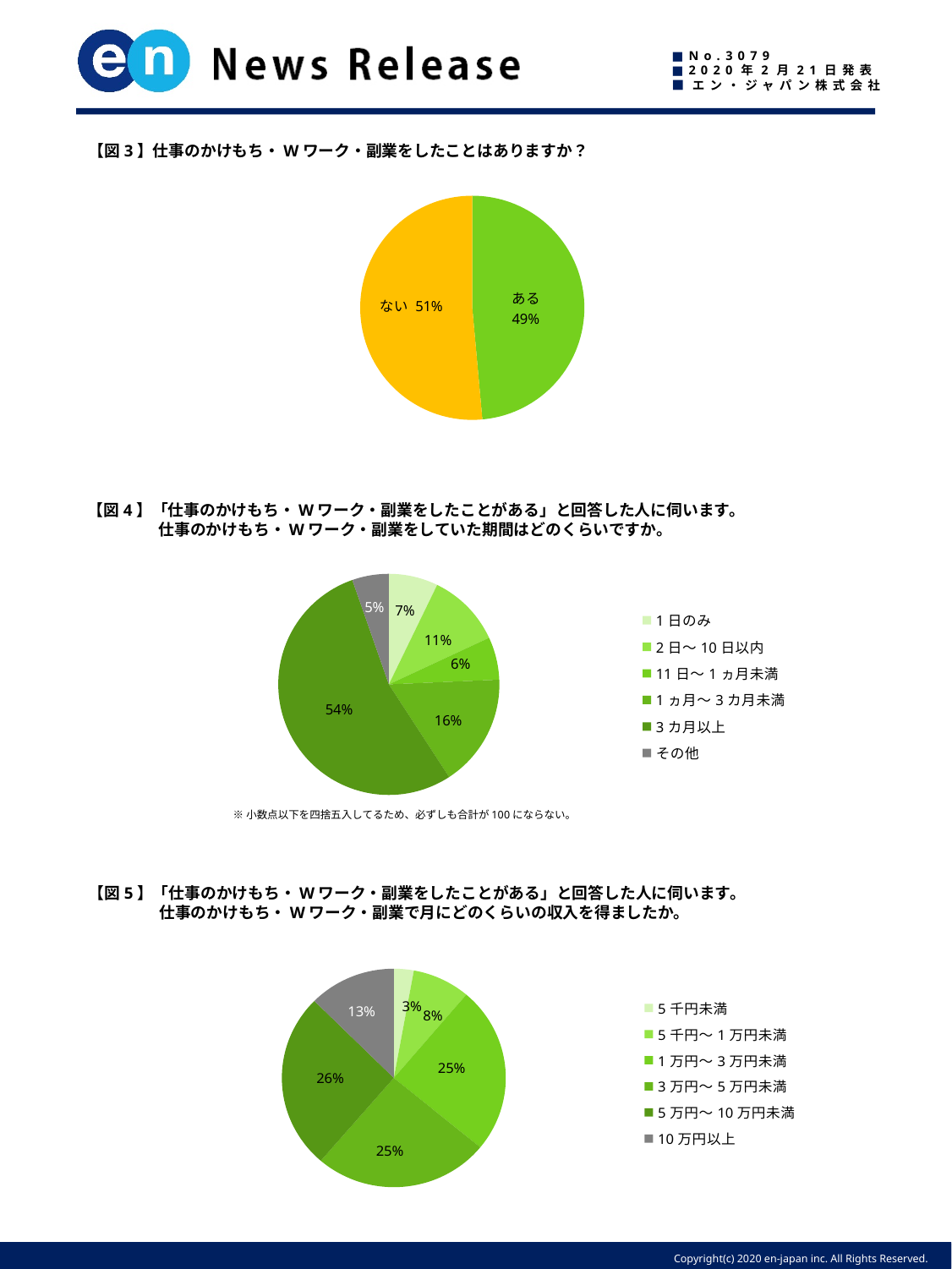
In the 【図3】 chart, which answer has the larger share, ある or ない? ない In the 【図4】 chart, which category has the smallest share? その他 How many categories does the legend of the 【図4】 chart list? 6 In the 【図4】 chart, what is the difference between the shares for 2日〜10日以内 and 11日〜1ヵ月未満? 5% In the 【図5】 chart, which category has the largest share? 5万円〜10万円未満 In the 【図5】 chart, what percentage is shown for 5千円未満? 3% In the 【図4】 chart, what percentage is shown for 1ヵ月〜3カ月未満? 16% What type of chart is used in 【図3】? Pie chart In the 【図5】 chart, what percentage is shown for 10万円以上? 13% In the 【図4】 chart, what percentage is shown for 3カ月以上? 54% In the 【図5】 chart, what is the difference between the shares for 5千円〜1万円未満 and 5千円未満? 5% In the 【図3】 chart, what percentage of respondents answered ある? 49%